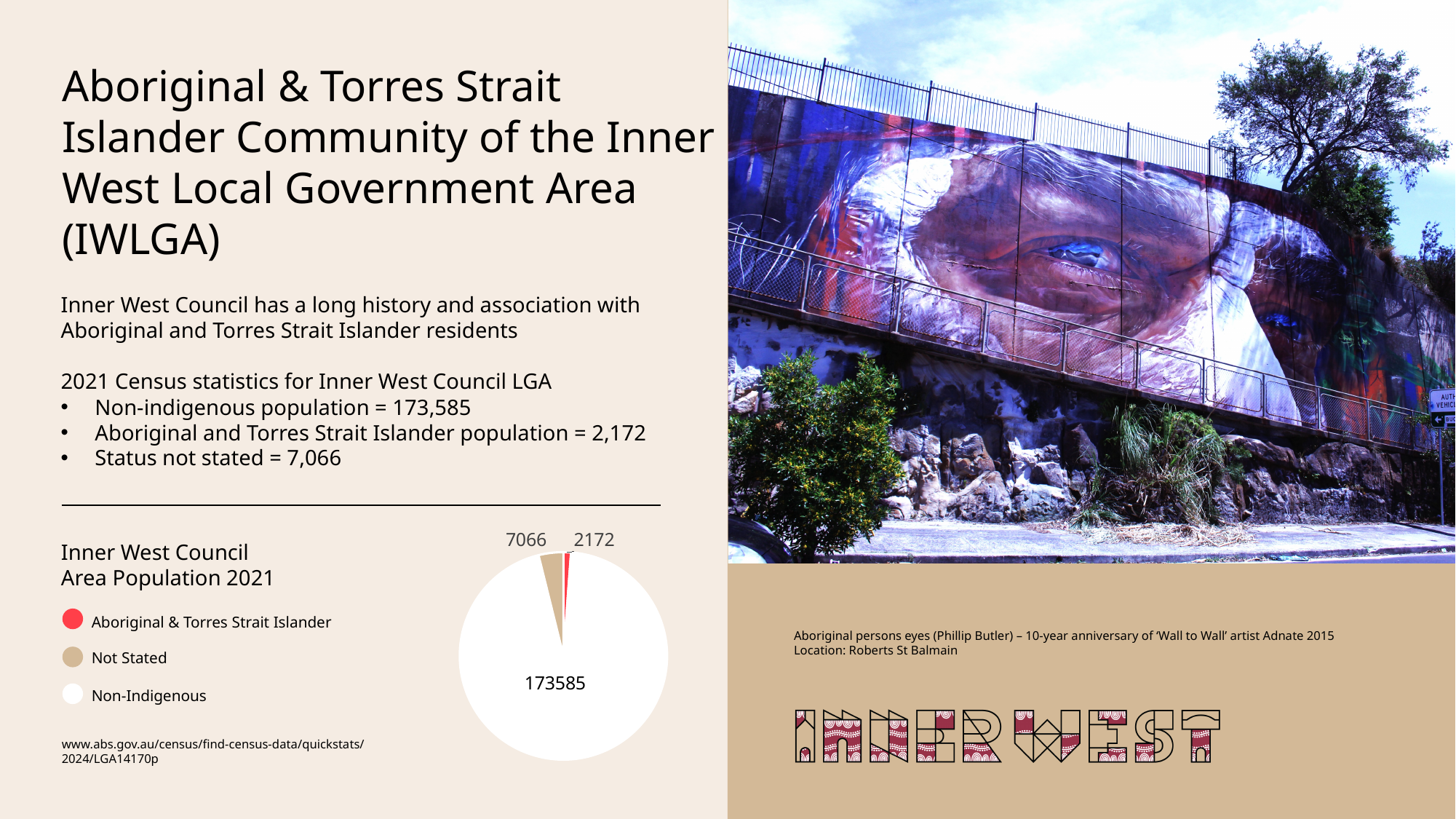
What is the title of the chart on the slide? Inner West Council Area Population 2021 Which category has the smallest slice in the pie chart? Aboriginal & Torres Strait Islander Which is larger in the pie chart, Not Stated or Aboriginal & Torres Strait Islander? Not Stated Which category has the largest slice in the pie chart? Non-Indigenous What value is shown for the Not Stated slice of the pie chart? 7066 Which colour represents the Aboriginal & Torres Strait Islander category in the pie chart? Red What value is shown for the Non-Indigenous slice of the pie chart? 173585 How many categories does the chart legend list? 3 What type of chart is shown on the slide? Pie chart How many slices does the pie chart have? 3 What is the difference between the Not Stated value and the Aboriginal & Torres Strait Islander value in the pie chart? 4894 What value is shown for the Aboriginal & Torres Strait Islander slice of the pie chart? 2172